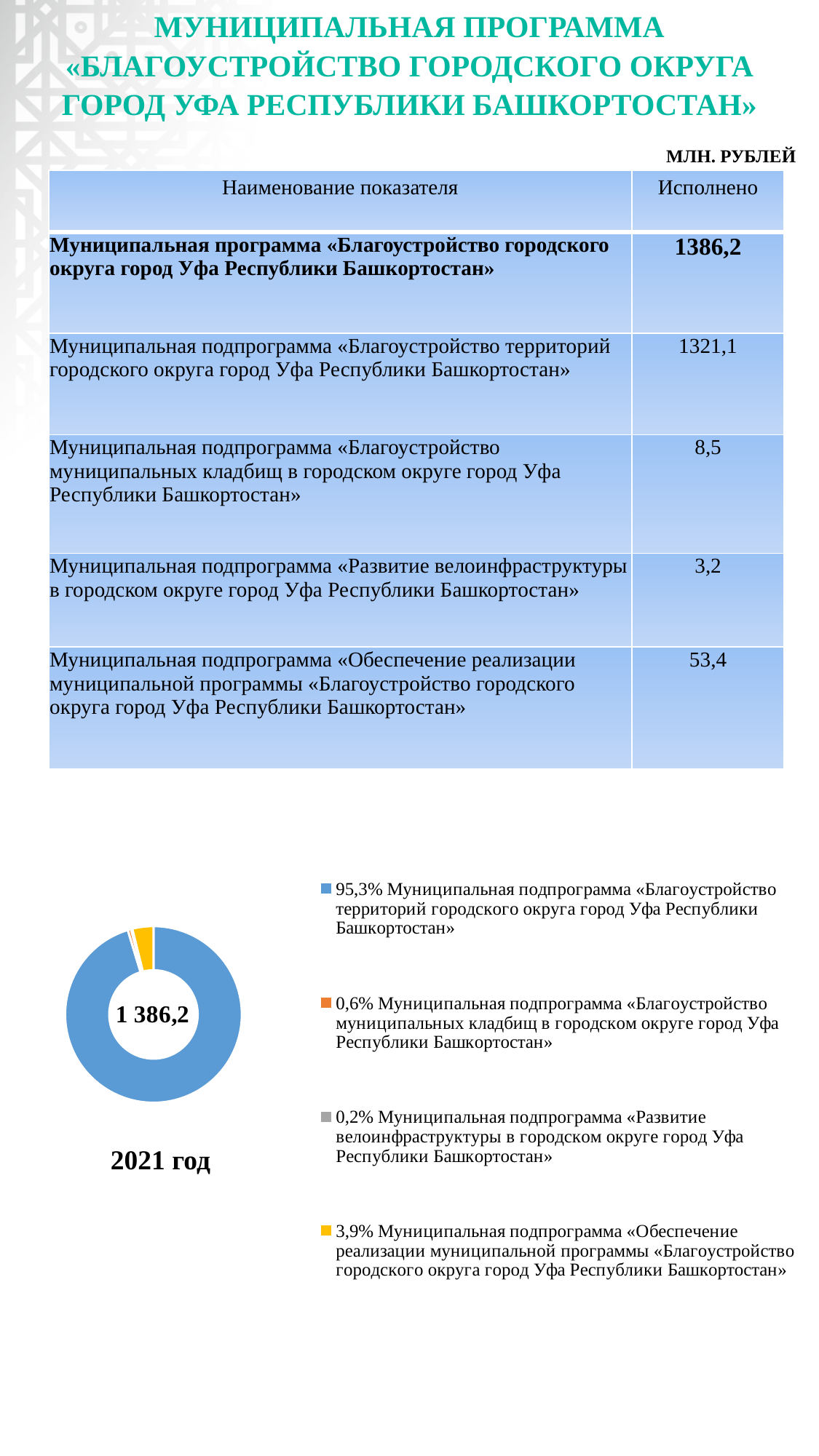
What total value is printed in the centre of the doughnut chart? 1 386,2 What year label is printed below the doughnut chart? 2021 год Which is larger in the doughnut chart: the share for «Обеспечение реализации муниципальной программы» or the share for «Благоустройство муниципальных кладбищ»? «Обеспечение реализации муниципальной программы» (3,9%) Which slice of the doughnut chart is the smallest? Муниципальная подпрограмма «Развитие велоинфраструктуры в городском округе город Уфа Республики Башкортостан» (0,2%) What share of the doughnut chart does the subprogramme «Благоустройство территорий городского округа город Уфа Республики Башкортостан» take? 95,3% What share of the doughnut chart does the subprogramme «Обеспечение реализации муниципальной программы «Благоустройство городского округа город Уфа Республики Башкортостан»» take? 3,9% How many slices does the doughnut chart have? 4 What share of the doughnut chart does the subprogramme «Развитие велоинфраструктуры в городском округе город Уфа Республики Башкортостан» take? 0,2% What kind of chart is shown at the bottom of the slide? Doughnut (pie) chart Which slice of the doughnut chart is the largest? Муниципальная подпрограмма «Благоустройство территорий городского округа город Уфа Республики Башкортостан» (95,3%) What is the difference in percentage points between the largest slice (95,3%) and the slice for «Обеспечение реализации муниципальной программы» (3,9%) in the doughnut chart? 91,4 percentage points